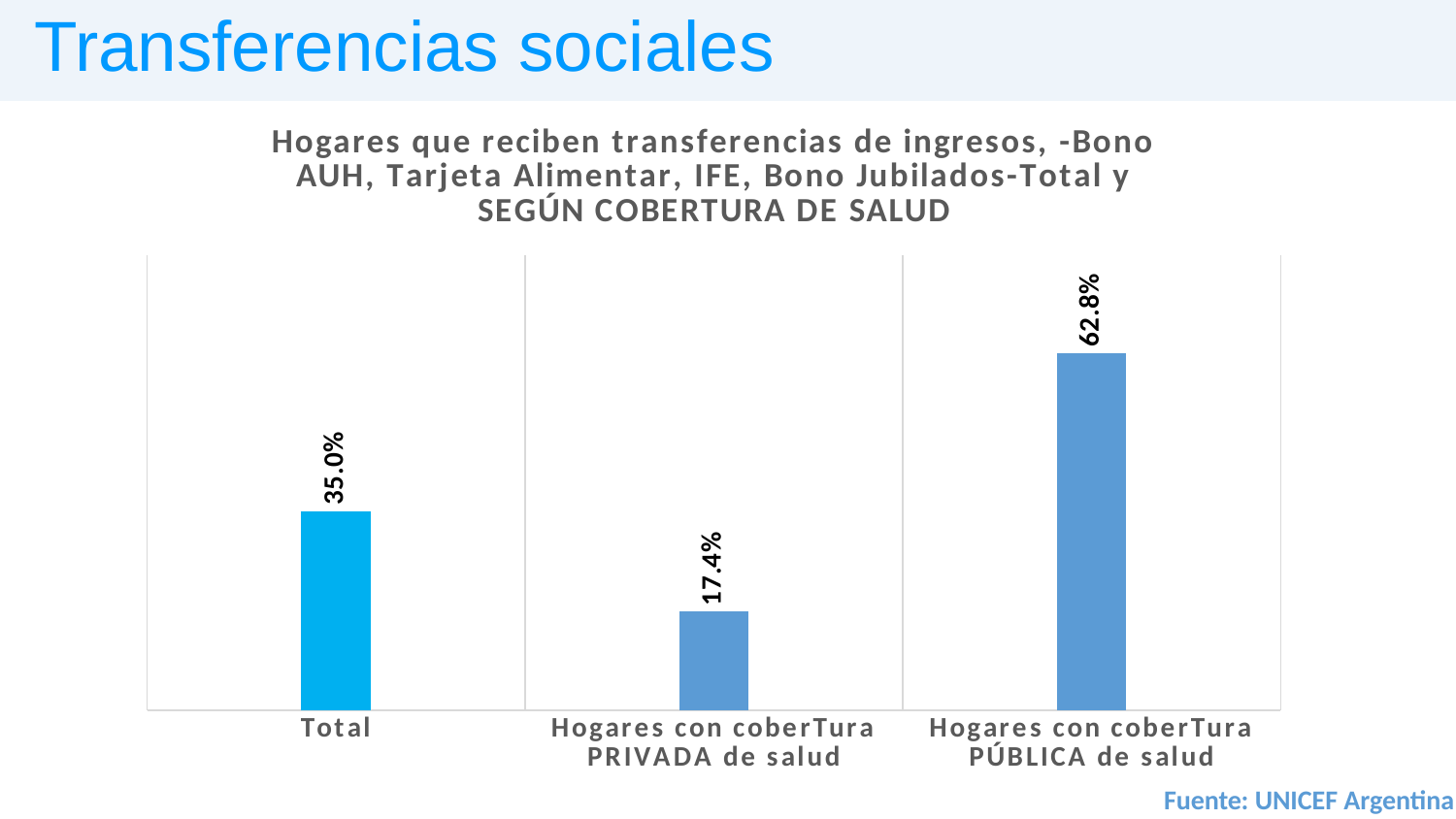
How many categories are shown in the chart? 3 Which category has the lowest value? Hogares con cobertura PRIVADA de salud What kind of chart is shown on the slide? Bar chart What is the value for Hogares con cobertura PÚBLICA de salud? 62.8% What is the source cited for the chart? UNICEF Argentina What is the value for Hogares con cobertura PRIVADA de salud? 17.4% What is the title of the slide? Transferencias sociales Which is larger, the value for Total or the value for Hogares con cobertura PRIVADA de salud? Total What is the value for Total? 35.0% What is the difference between the values for Hogares con cobertura PÚBLICA de salud and Hogares con cobertura PRIVADA de salud? 45.4% Which category has the highest value? Hogares con cobertura PÚBLICA de salud What is the difference between the values for Total and Hogares con cobertura PRIVADA de salud? 17.6%